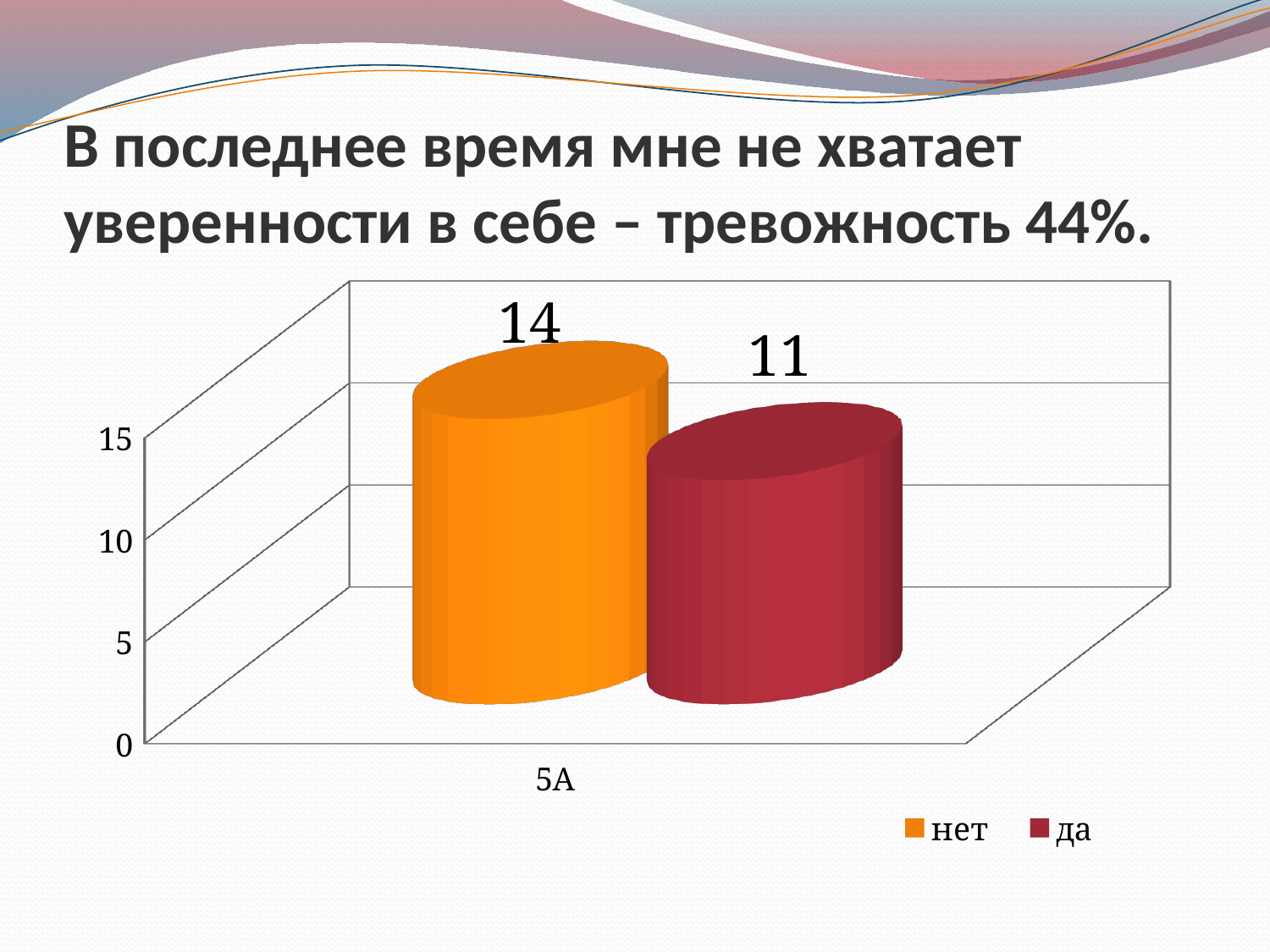
What is the total of the "нет" and "да" values? 25 What is the difference between the "нет" and "да" values? 3 Which series has the lowest value on the chart? да Is the value for "да" greater or less than 10? greater Which series has the higher value, "нет" or "да"? нет How many categories are shown on the x axis? 1 What colour is the bar for "да"? dark red What kind of chart is shown on the slide? bar chart How many series does the legend list? 2 What is the value for "нет" in class 5А? 14 Is the value for "нет" greater or less than 15? less What is the value for "да" in class 5А? 11